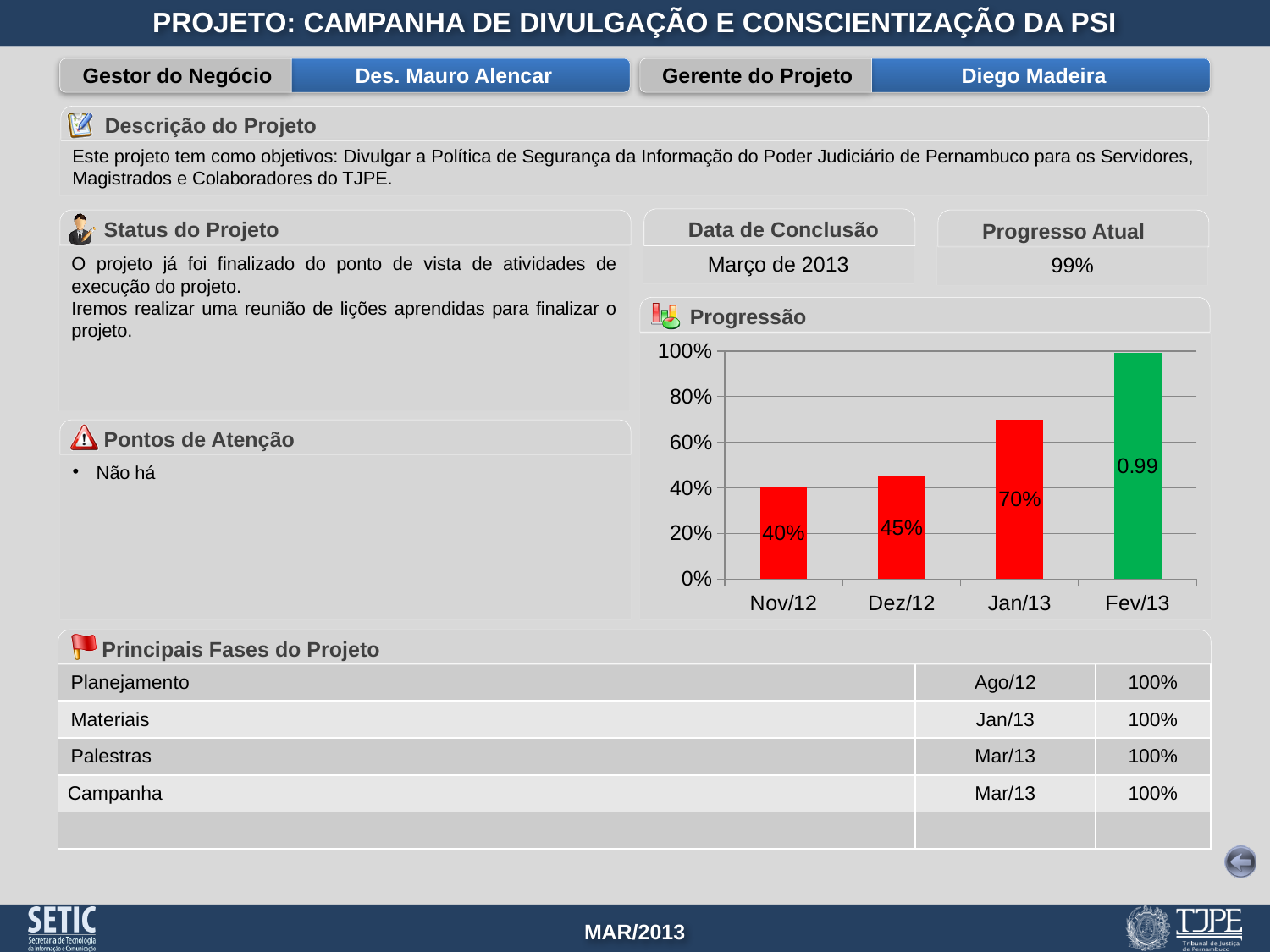
In the Progressão chart, which month has the highest bar? Fev/13 In the Progressão chart, which month has the lowest bar? Nov/12 How many months are plotted in the Progressão chart? 4 In the Progressão chart, is the value for Fev/13 greater or less than 80%? greater In the Progressão chart, what is the value for Dez/12? 45% In the Progressão chart, what is the value for Jan/13? 70% In the Progressão chart, what is the value for Nov/12? 40% In the Progressão chart, do the values rise or fall from Nov/12 to Fev/13? rise In the Progressão chart, which is larger, the value for Jan/13 or the value for Dez/12? Jan/13 In the Progressão chart, what is the difference between the values for Jan/13 and Dez/12? 25% In the Progressão chart, what data label is printed on the Fev/13 bar? 0.99 What type of chart is shown under "Progressão"? bar chart